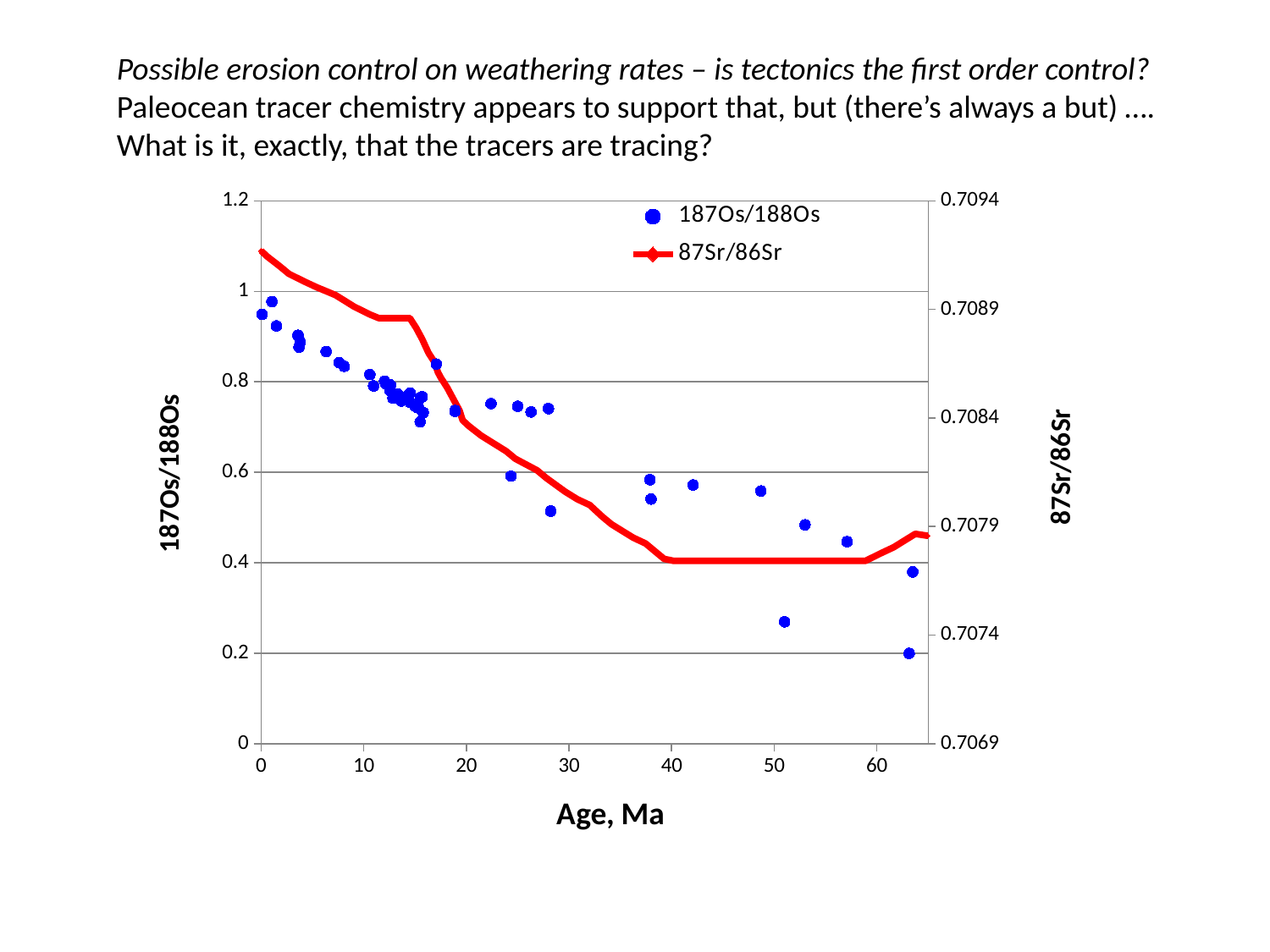
Do the 187Os/188Os values generally rise or fall as age increases along the x axis? fall Is the 87Sr/86Sr value at age 30 Ma greater or less than 0.7084? less Is the 87Sr/86Sr value at age 0 Ma greater or less than 0.7089? greater Do the 87Sr/86Sr values generally rise or fall as age increases from 0 to 40 Ma? fall Is the 87Sr/86Sr value at age 50 Ma greater or less than 0.7079? less What is the title of the x axis? Age, Ma What are the two series named in the legend? 187Os/188Os and 87Sr/86Sr Which series is plotted as a red line? 87Sr/86Sr What kind of chart is shown on the slide? scatter chart How many series does the legend list? 2